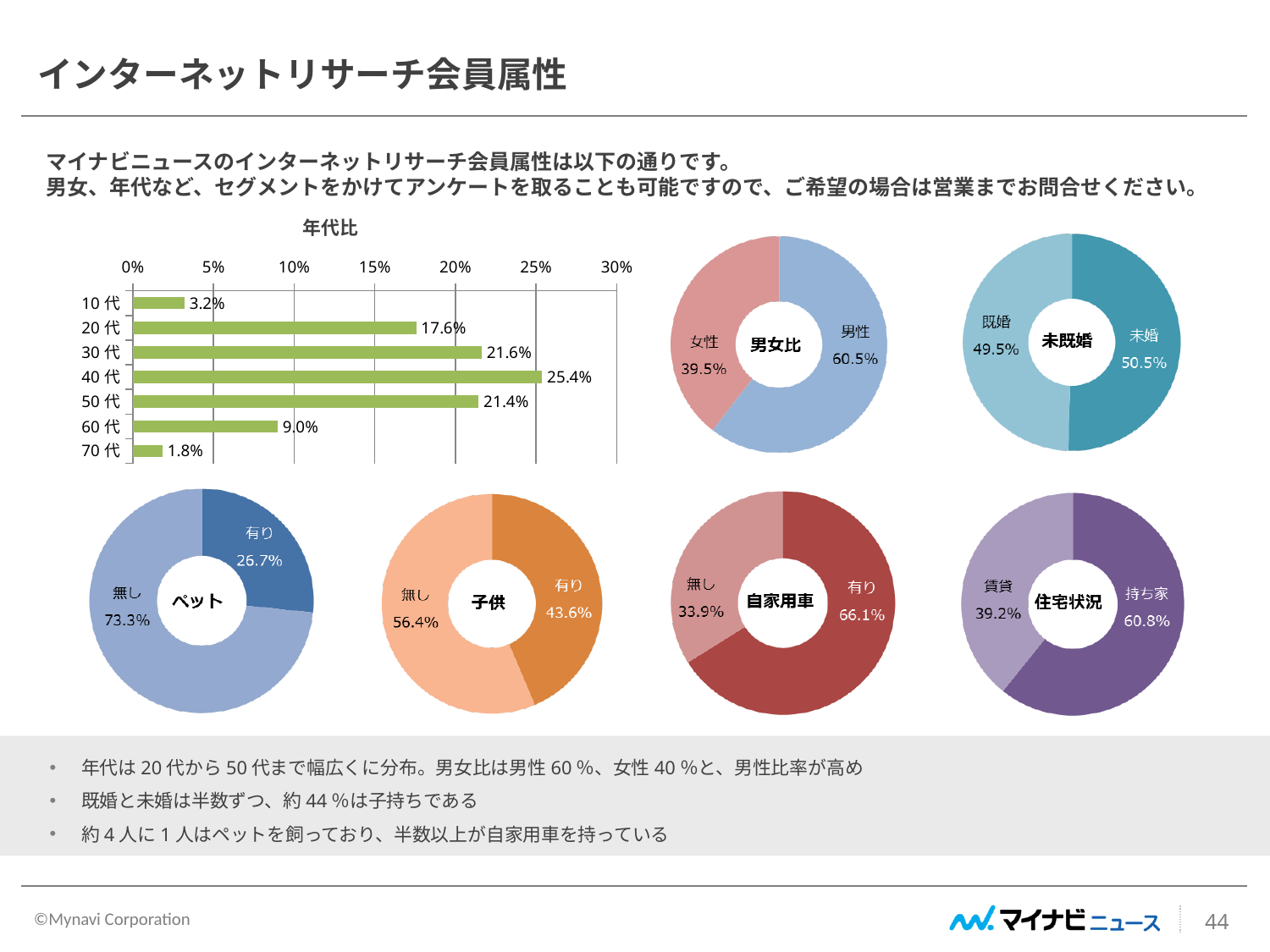
In the 年代比 chart, what is the value for 40代? 25.4% In the 年代比 chart, which age group has the highest value? 40代 In the ペット chart, what is the share for 無し? 73.3% In the 自家用車 chart, what is the difference between 有り and 無し? 32.2% In the 年代比 chart, what is the difference between the values for 20代 and 60代? 8.6% In the 年代比 chart, how many age groups are shown? 7 What kind of chart is the 年代比 chart? bar chart In the 未既婚 chart, which is larger, 既婚 or 未婚? 未婚 In the 年代比 chart, which age group has the lowest value? 70代 In the 子供 chart, what is the share for 有り? 43.6% In the 住宅状況 chart, what is the share for 持ち家? 60.8%